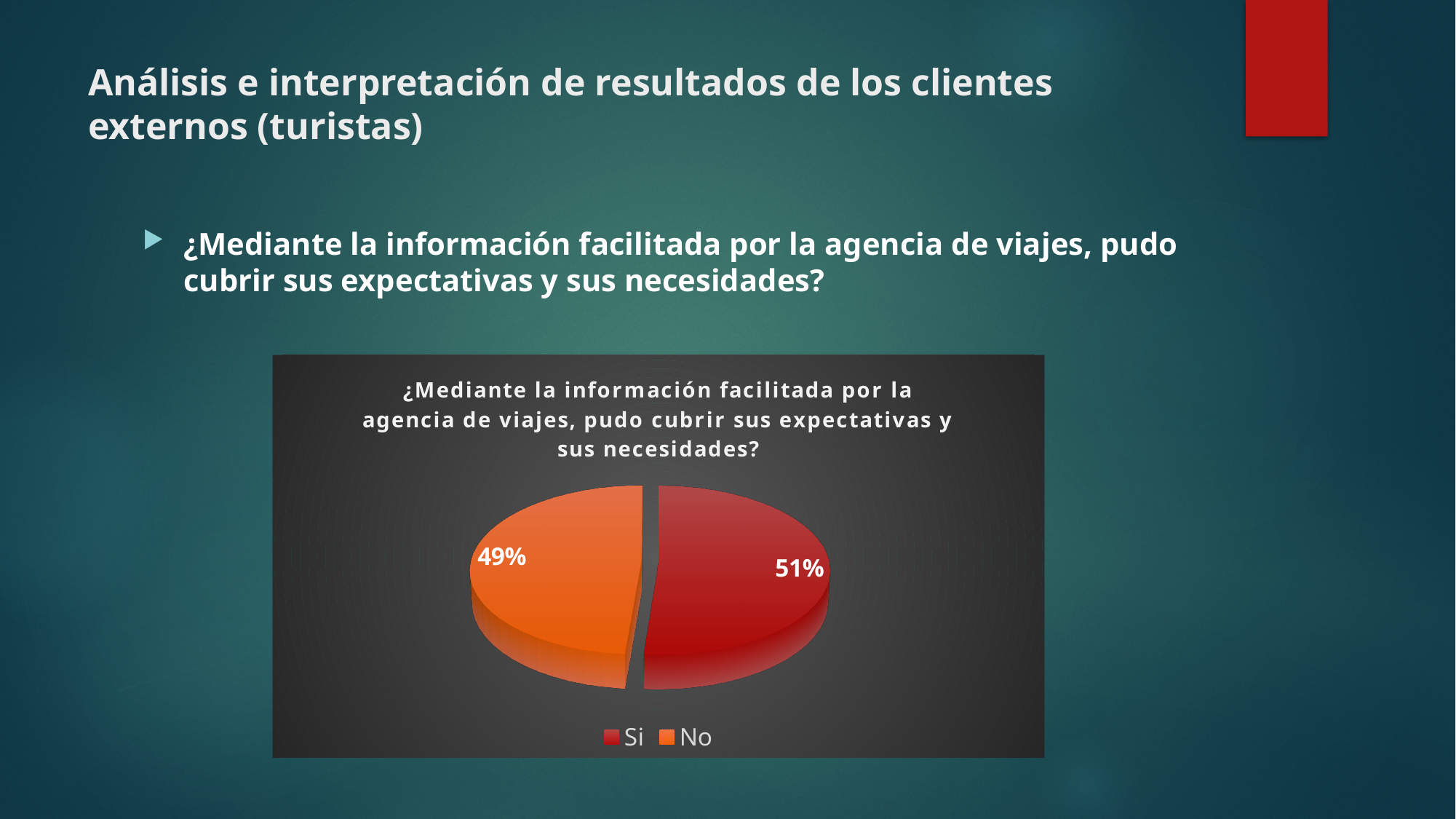
What percentage of the pie is labelled for "Si"? 51% What colour is the "No" slice of the pie? orange How many slices does the pie chart have? 2 Which slice of the pie is the smallest? No What percentage of the pie is labelled for "No"? 49% How many entries does the legend list? 2 What is the difference in percentage points between the "Si" and "No" slices? 2 Which is larger, the "Si" slice or the "No" slice? Si What colour is the "Si" slice of the pie? red Which slice of the pie is the largest? Si What kind of chart is shown on the slide? pie chart